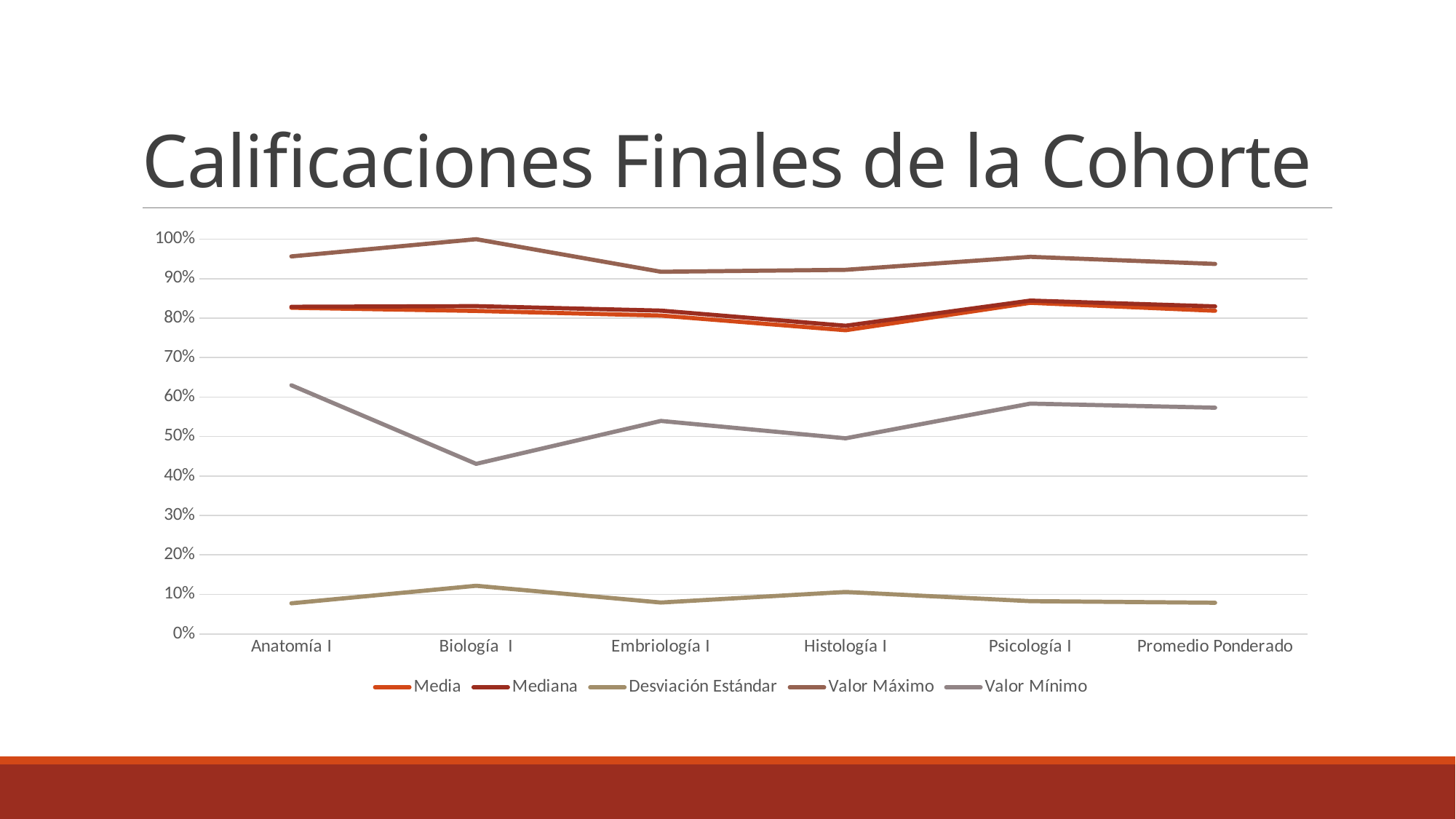
Is the value of Media for Histología I greater or less than 80%? less How many categories are shown on the x axis? 6 For which category is Valor Máximo highest? Biología I Does Valor Mínimo rise or fall from Biología I to Psicología I? rise How many series does the legend list? 5 What is the title of the chart? Calificaciones Finales de la Cohorte Which is larger, Valor Mínimo for Anatomía I or Valor Mínimo for Embriología I? Anatomía I What is the value of Valor Máximo for Biología I? 100% What kind of chart is shown on the slide? line chart Is the value of Desviación Estándar for Biología I greater or less than 10%? greater For which category is Valor Mínimo lowest? Biología I Is the value of Valor Mínimo for Biología I greater or less than 50%? less